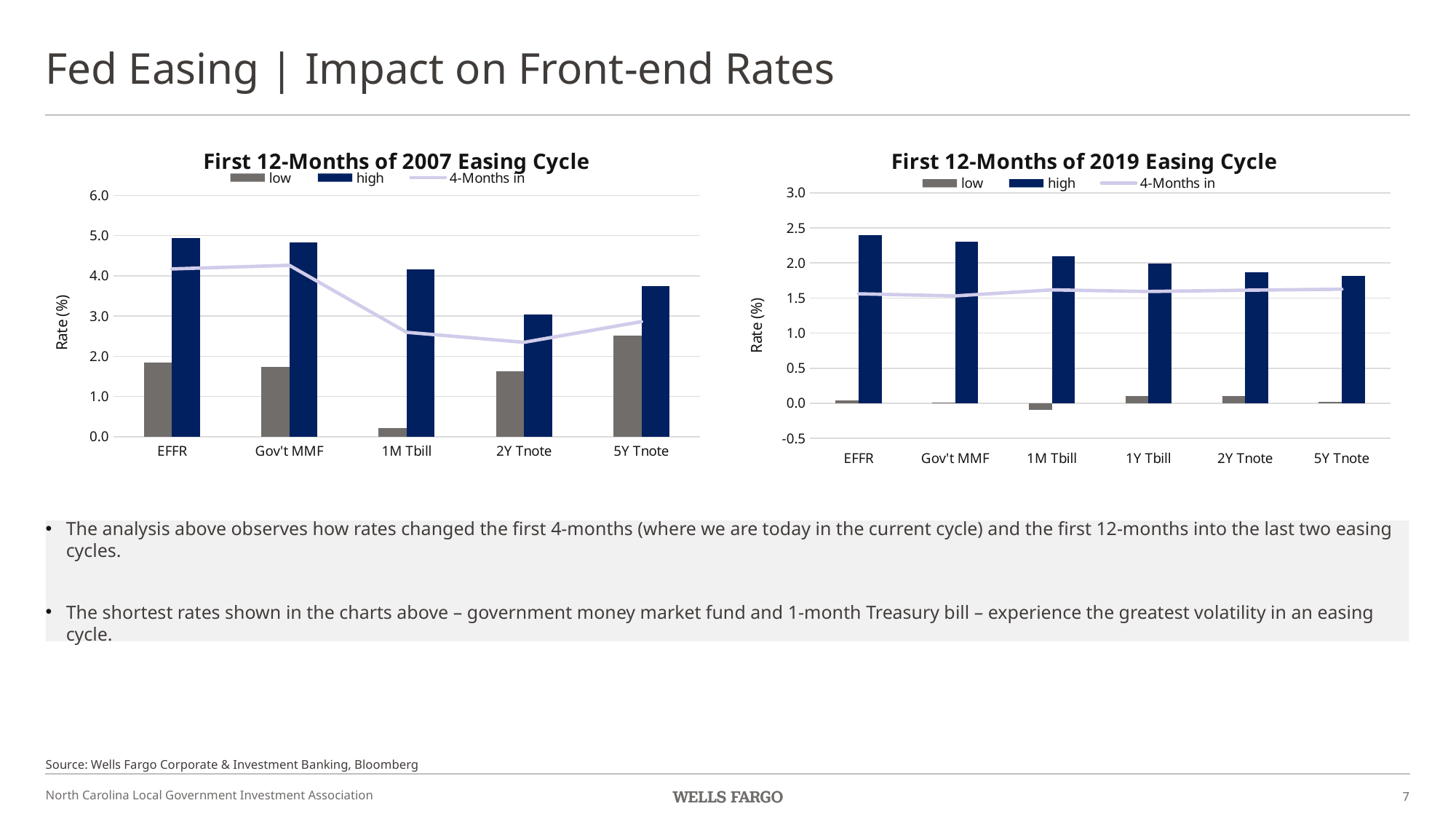
How many series does the legend list in the 'First 12-Months of 2007 Easing Cycle' chart? 3 In the 'First 12-Months of 2019 Easing Cycle' chart, which category has the lowest 'low' bar? 1M Tbill What is the y-axis label on the 'First 12-Months of 2019 Easing Cycle' chart? Rate (%) How many categories are shown on the x axis of the 'First 12-Months of 2019 Easing Cycle' chart? 6 In the 'First 12-Months of 2007 Easing Cycle' chart, which category has the highest 'low' bar? 5Y Tnote How many categories are shown on the x axis of the 'First 12-Months of 2007 Easing Cycle' chart? 5 In the 'First 12-Months of 2007 Easing Cycle' chart, which category has the lowest 'low' bar? 1M Tbill In the 'First 12-Months of 2007 Easing Cycle' chart, which category has the lowest 'high' bar? 2Y Tnote What type of chart is the 'First 12-Months of 2007 Easing Cycle' chart? bar chart with a line In the 'First 12-Months of 2019 Easing Cycle' chart, is the 'high' value for 5Y Tnote greater or less than 2.0? less In the 'First 12-Months of 2007 Easing Cycle' chart, is the 'high' value for EFFR greater or less than 4.0? greater In the 'First 12-Months of 2019 Easing Cycle' chart, do the 'high' bars rise or fall from EFFR to 5Y Tnote? fall